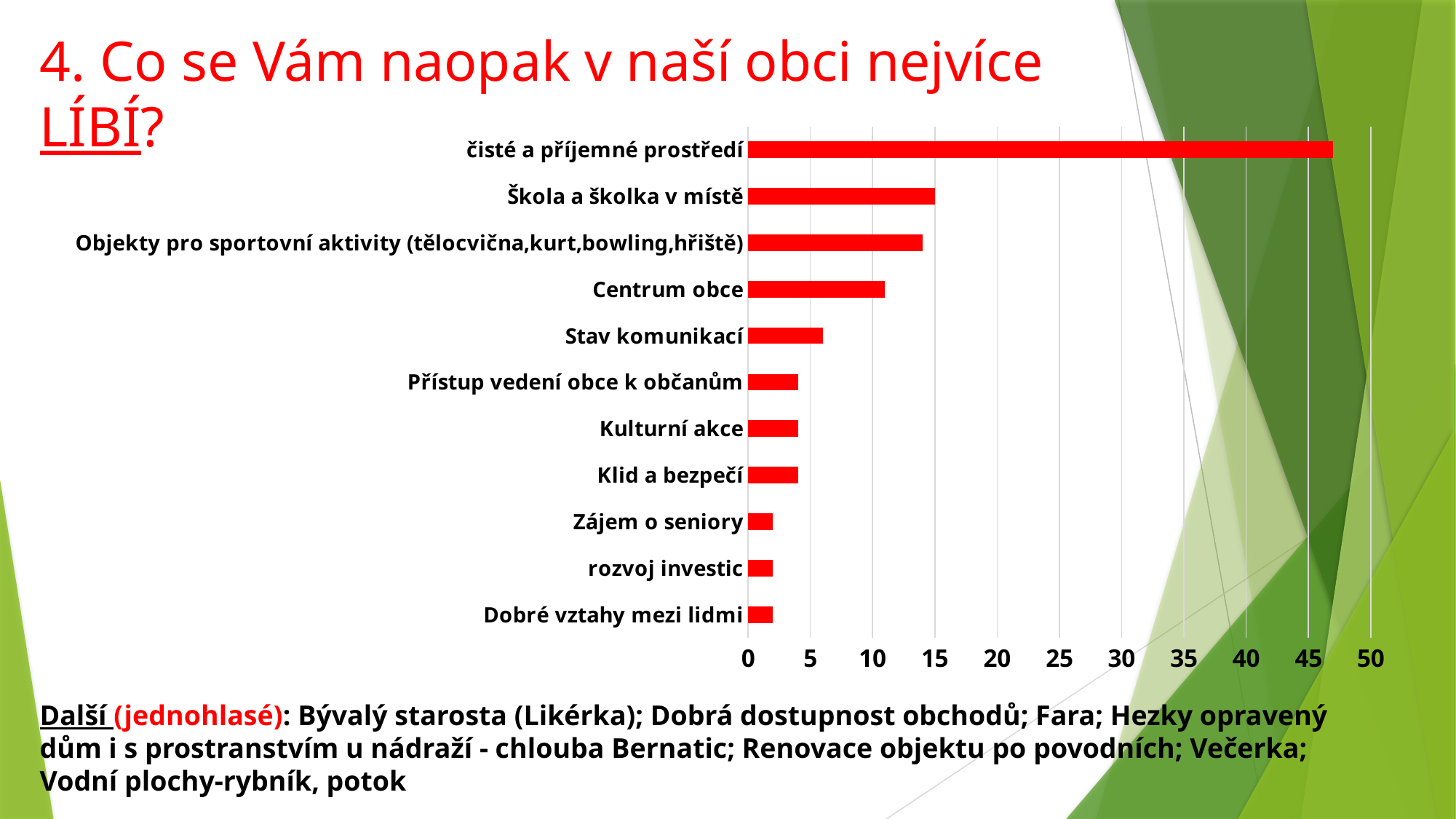
Is the value for čisté a příjemné prostředí greater or less than 45? greater What kind of chart is shown on the slide? bar chart What is the highest value shown on the horizontal axis of the chart? 50 Which category has the highest value in the chart? čisté a příjemné prostředí Which has a larger value, Škola a školka v místě or Centrum obce? Škola a školka v místě Is the value for Stav komunikací greater or less than 10? less Which has a larger value, Stav komunikací or Kulturní akce? Stav komunikací What colour are the bars in the chart? red Is the value for Zájem o seniory greater or less than 5? less How many categories are plotted in the chart? 11